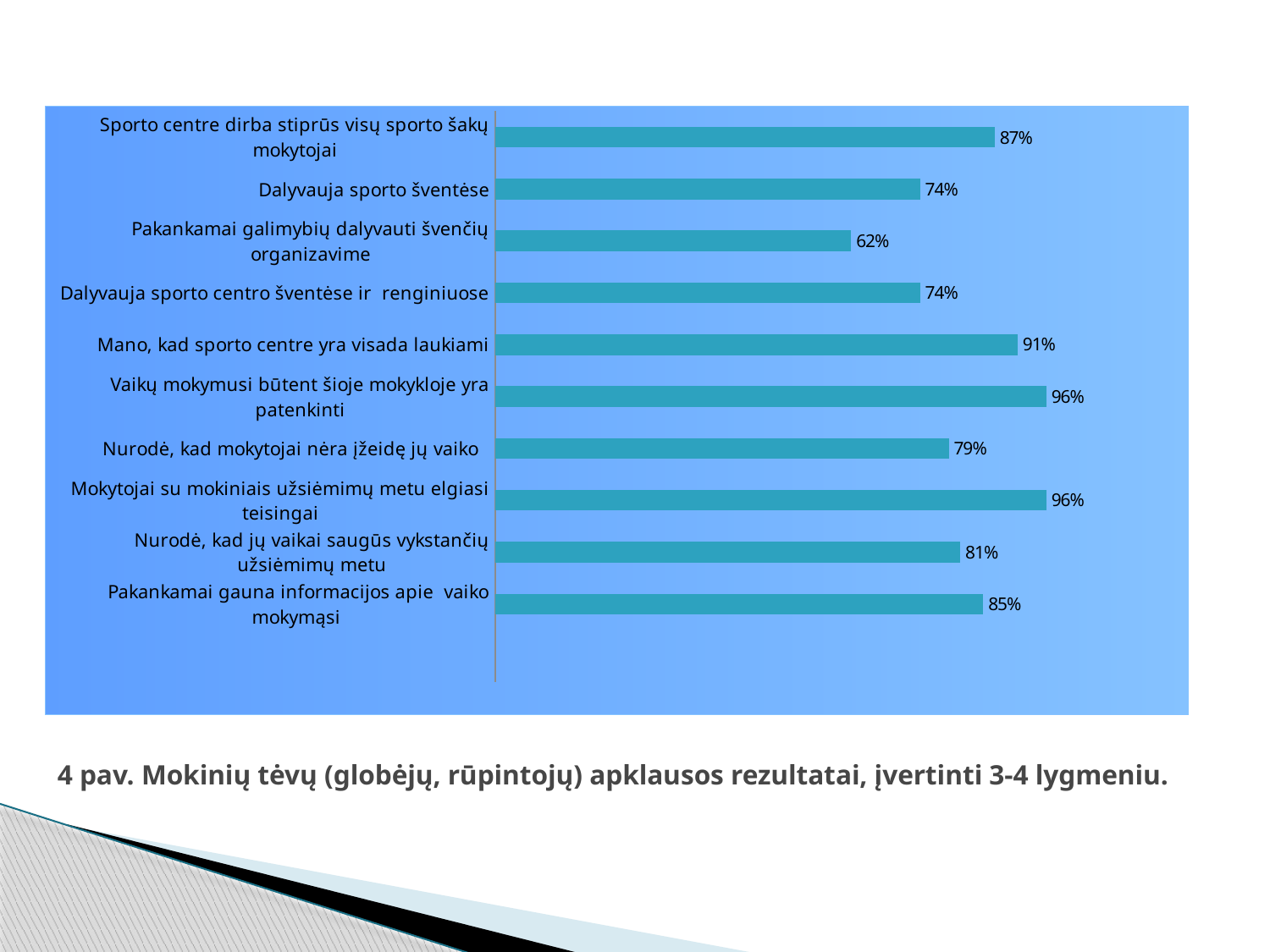
What is the value for "Pakankamai galimybių dalyvauti švenčių organizavime"? 62% What kind of chart is shown on the slide? Bar chart What is the caption below the chart? 4 pav. Mokinių tėvų (globėjų, rūpintojų) apklausos rezultatai, įvertinti 3-4 lygmeniu. How many categories are shown on the chart? 10 What is the value for "Pakankamai gauna informacijos apie vaiko mokymąsi"? 85% What is the difference between "Vaikų mokymusi būtent šioje mokykloje yra patenkinti" and "Nurodė, kad jų vaikai saugūs vykstančių užsiėmimų metu"? 15% Which is larger: the value for "Sporto centre dirba stiprūs visų sporto šakų mokytojai" or for "Nurodė, kad jų vaikai saugūs vykstančių užsiėmimų metu"? Sporto centre dirba stiprūs visų sporto šakų mokytojai What is the value for "Nurodė, kad mokytojai nėra įžeidę jų vaiko"? 79% Which category has the lowest value? Pakankamai galimybių dalyvauti švenčių organizavime What is the highest value shown on the chart? 96% What is the difference between "Mano, kad sporto centre yra visada laukiami" and "Dalyvauja sporto šventėse"? 17% What is the value for "Sporto centre dirba stiprūs visų sporto šakų mokytojai"? 87%